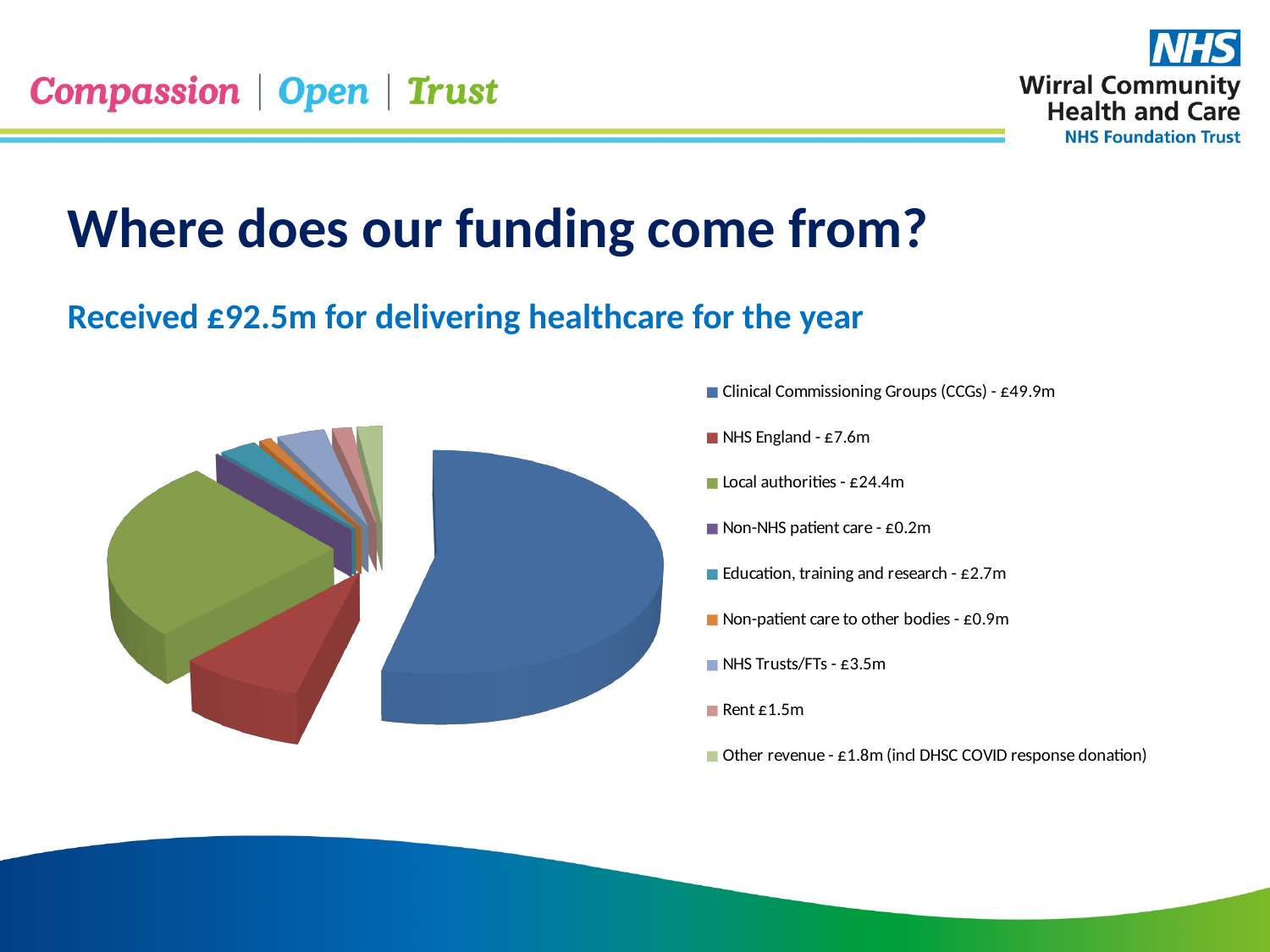
What is the value for NHS Trusts/FTs? £3.5m What is the value for Local authorities? £24.4m Which funding source is the largest? Clinical Commissioning Groups (CCGs) What is the title of the slide containing the chart? Where does our funding come from? What is the difference between the CCGs value and the Local authorities value? £25.5m What is the value for Clinical Commissioning Groups (CCGs)? £49.9m Which is larger, NHS England or NHS Trusts/FTs? NHS England What type of chart is shown on the slide? Pie chart Which funding source is the smallest? Non-NHS patient care How many funding sources (slices) does the pie chart show? 9 What is the total funding received for the year, as stated on the slide? £92.5m What is the value for Education, training and research? £2.7m